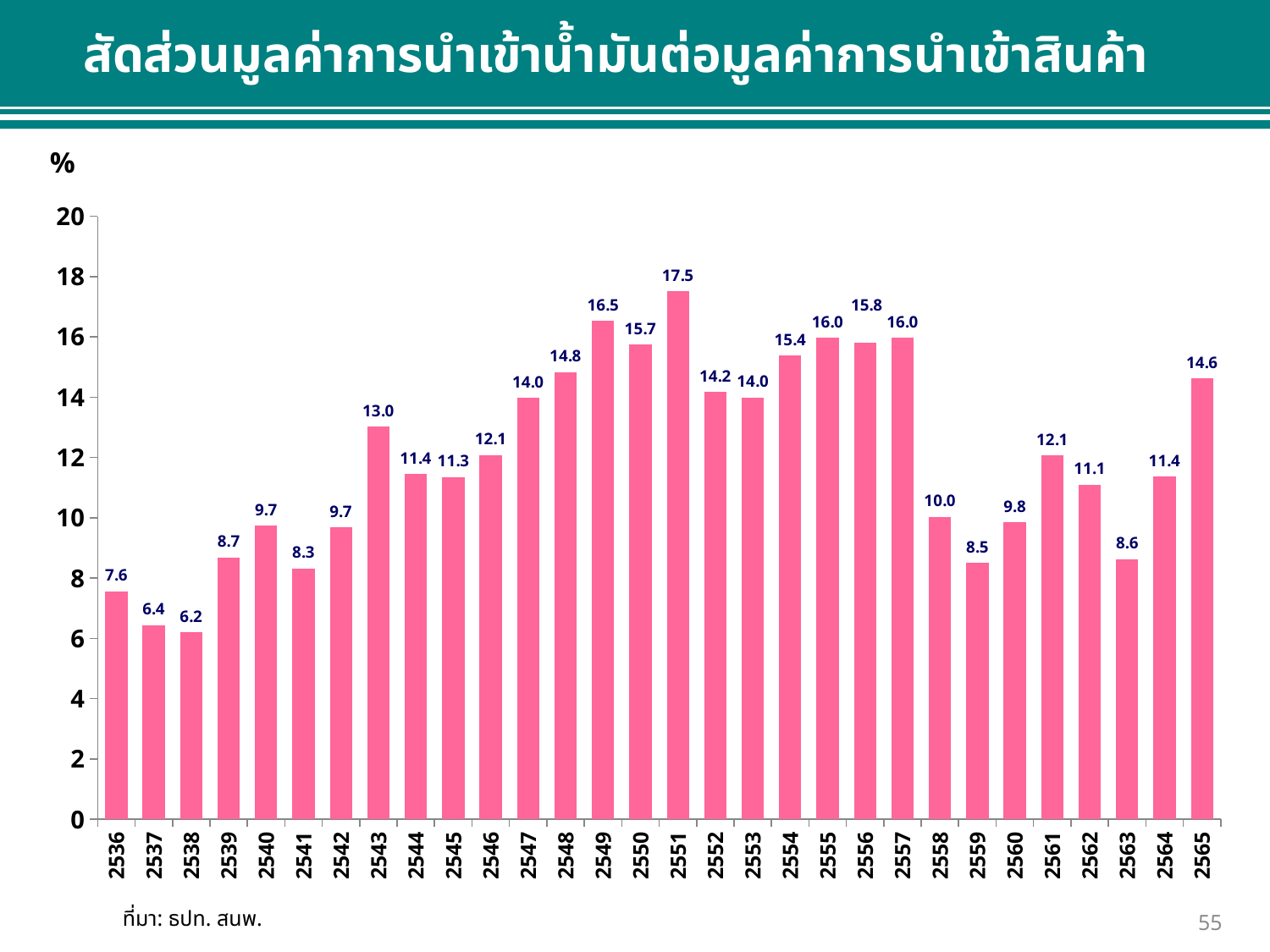
What is the value for 2551? 17.5 What is the value for 2543? 13.0 Which year has the lowest value? 2538 What is the value for 2565? 14.6 Which is larger, the value for 2549 or the value for 2550? 2549 What is the difference between the values for 2551 and 2538? 11.3 How many years are shown on the x axis? 30 Is the value for 2558 greater or less than 12? less Which year has the highest value? 2551 What type of chart is shown on the slide? bar chart What is the difference between the values for 2565 and 2564? 3.2 What unit is shown at the top of the y axis? %